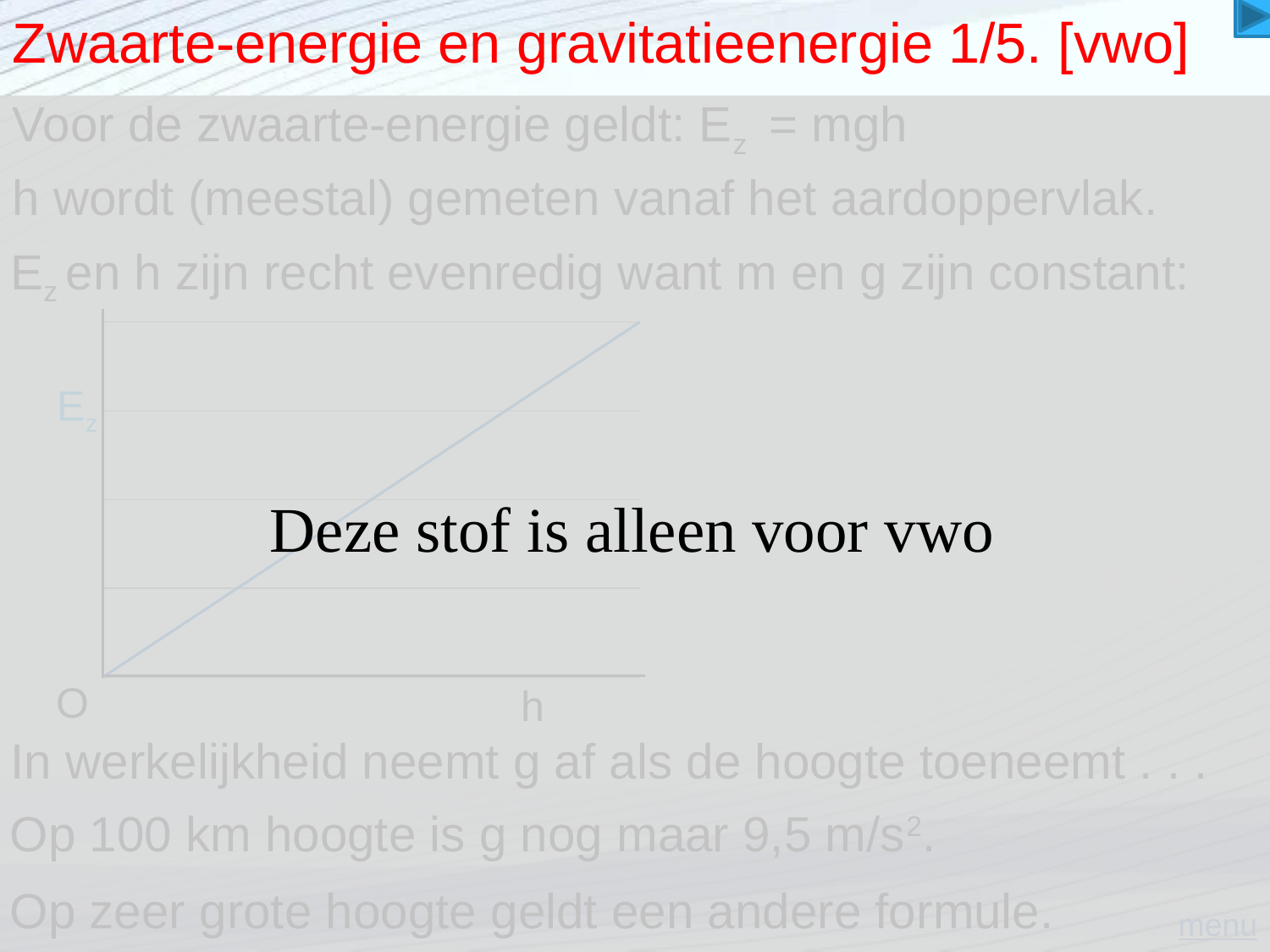
What quantity is labelled on the vertical axis of the chart? Ez How many lines are plotted on the chart? 1 Does the plotted line rise or fall as h increases along the x axis? rises What kind of chart is shown on the slide? line chart What quantity is labelled on the horizontal axis of the chart? h Is the plotted line straight or curved? straight